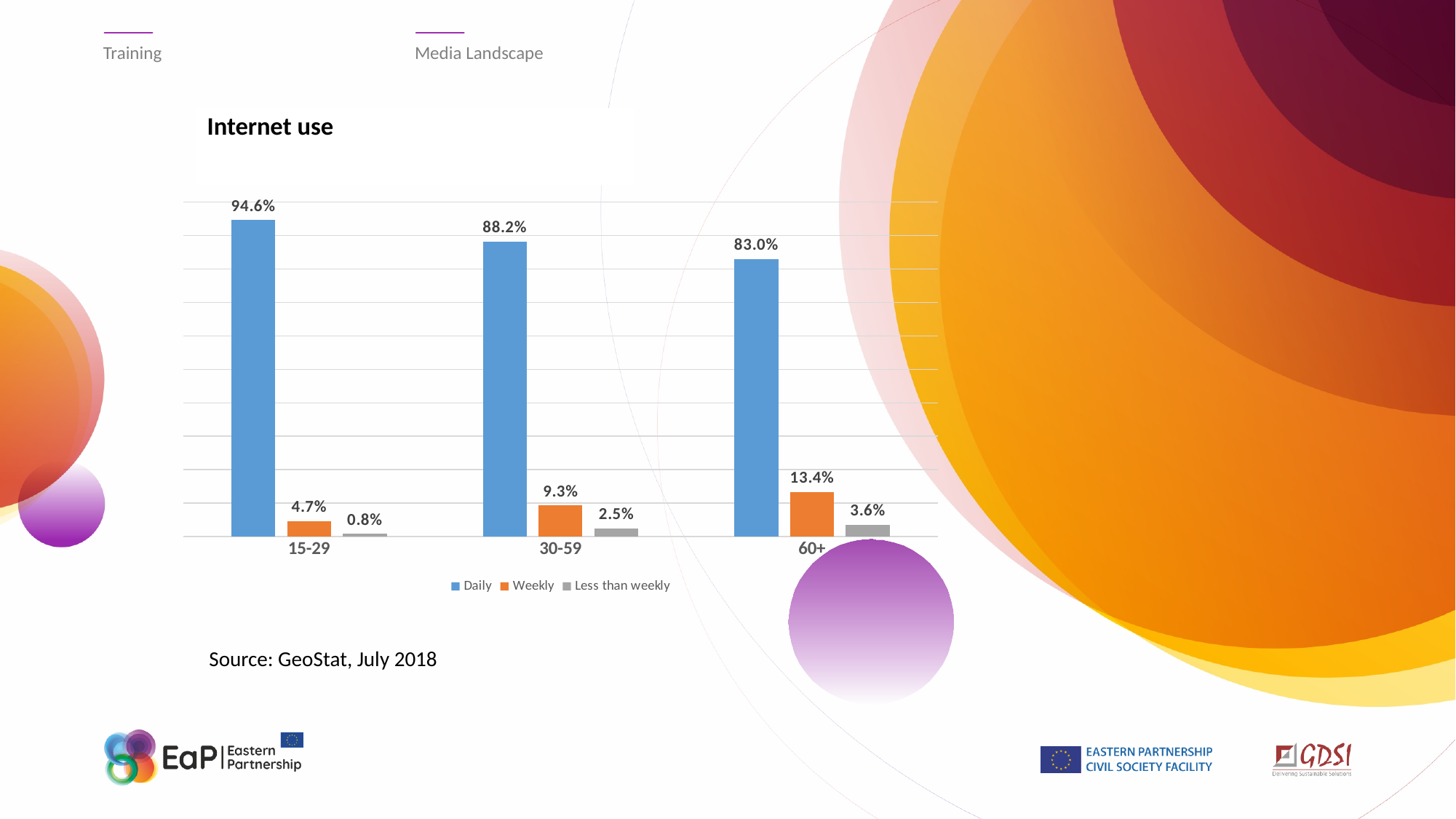
What is the difference between Daily internet use for 15-29 and for 60+? 11.6% Which age group has the highest Daily internet use? 15-29 What kind of chart is shown on the slide? Bar chart What is the Weekly internet use value for the 60+ age group? 13.4% What is the title of the chart? Internet use What is the Daily internet use value for the 15-29 age group? 94.6% How many series does the legend list? 3 Which age group has the lowest Less than weekly internet use? 15-29 Which is larger: Weekly internet use for 30-59 or for 60+? 60+ Does Daily internet use rise or fall as age group increases along the x axis? Fall How many age groups are shown on the x axis? 3 What is the Less than weekly internet use value for the 30-59 age group? 2.5%